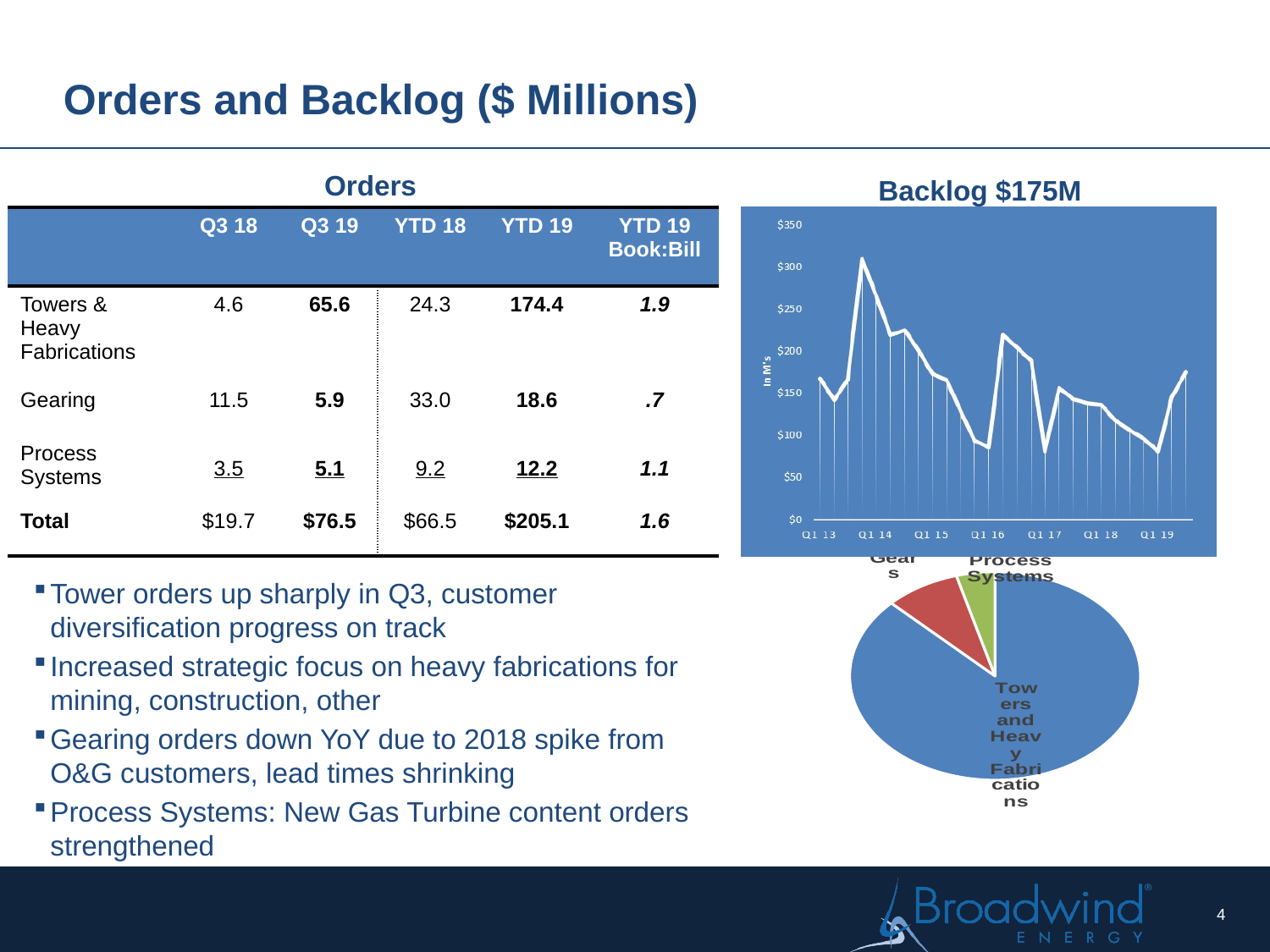
In the pie chart, which is larger, the Gears segment or the Process Systems segment? Gears In the Backlog $175M chart, is the lowest value between Q1 16 and Q1 17 greater or less than $100? less In the Backlog $175M chart, does the backlog rise or fall between Q1 14 and Q1 15? fall In the pie chart, which segment is the largest? Towers and Heavy Fabrications What kind of chart is shown below the Backlog $175M chart? pie chart In the pie chart, which segment is the smallest? Process Systems In the Backlog $175M chart, what is the label on the y axis? In M's In the Backlog $175M chart, how many quarter labels are shown on the x axis? 7 In the Backlog $175M chart, is the final value at the right end of the line greater or less than $150? greater In the Backlog $175M chart, what is the highest value shown on the y axis? $350 In the Backlog $175M chart, is the peak value around Q1 14 greater or less than $250? greater What kind of chart is the Backlog $175M chart? line chart